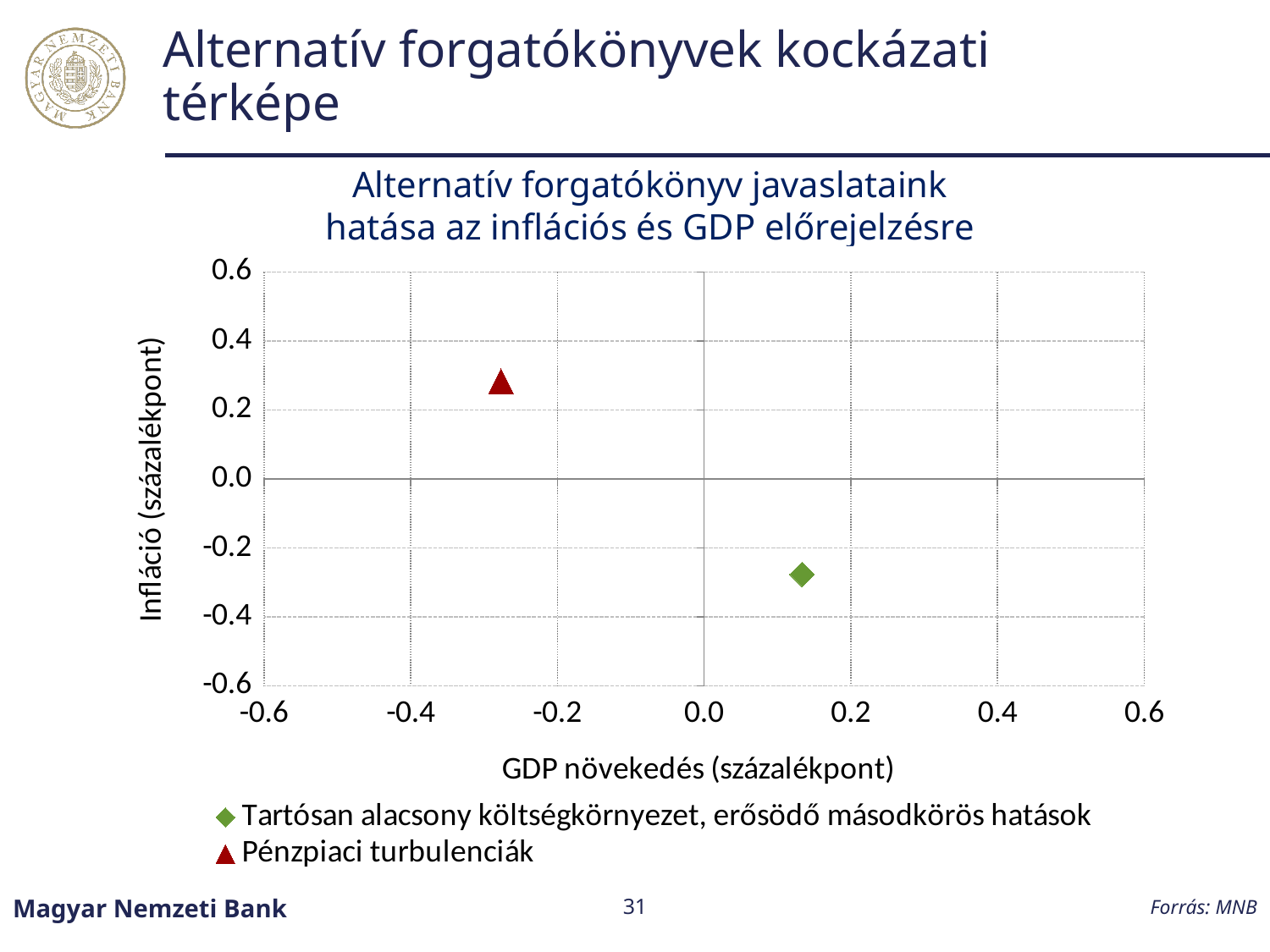
What is the label of the vertical axis? Infláció (százalékpont) Is the GDP growth value for the 'Tartósan alacsony költségkörnyezet, erősödő másodkörös hatások' point greater or less than 0.0? greater Is the inflation value for the 'Pénzpiaci turbulenciák' point greater or less than 0.2? greater Which scenario has the higher inflation effect? Pénzpiaci turbulenciák What kind of chart is shown on the slide? Scatter chart Is the inflation value for the 'Tartósan alacsony költségkörnyezet, erősödő másodkörös hatások' point greater or less than -0.2? less What marker shape and colour represent the 'Pénzpiaci turbulenciák' series? Red triangle Which scenario has the higher GDP growth effect? Tartósan alacsony költségkörnyezet, erősödő másodkörös hatások How many data points are plotted on the chart? 2 How many series does the legend list? 2